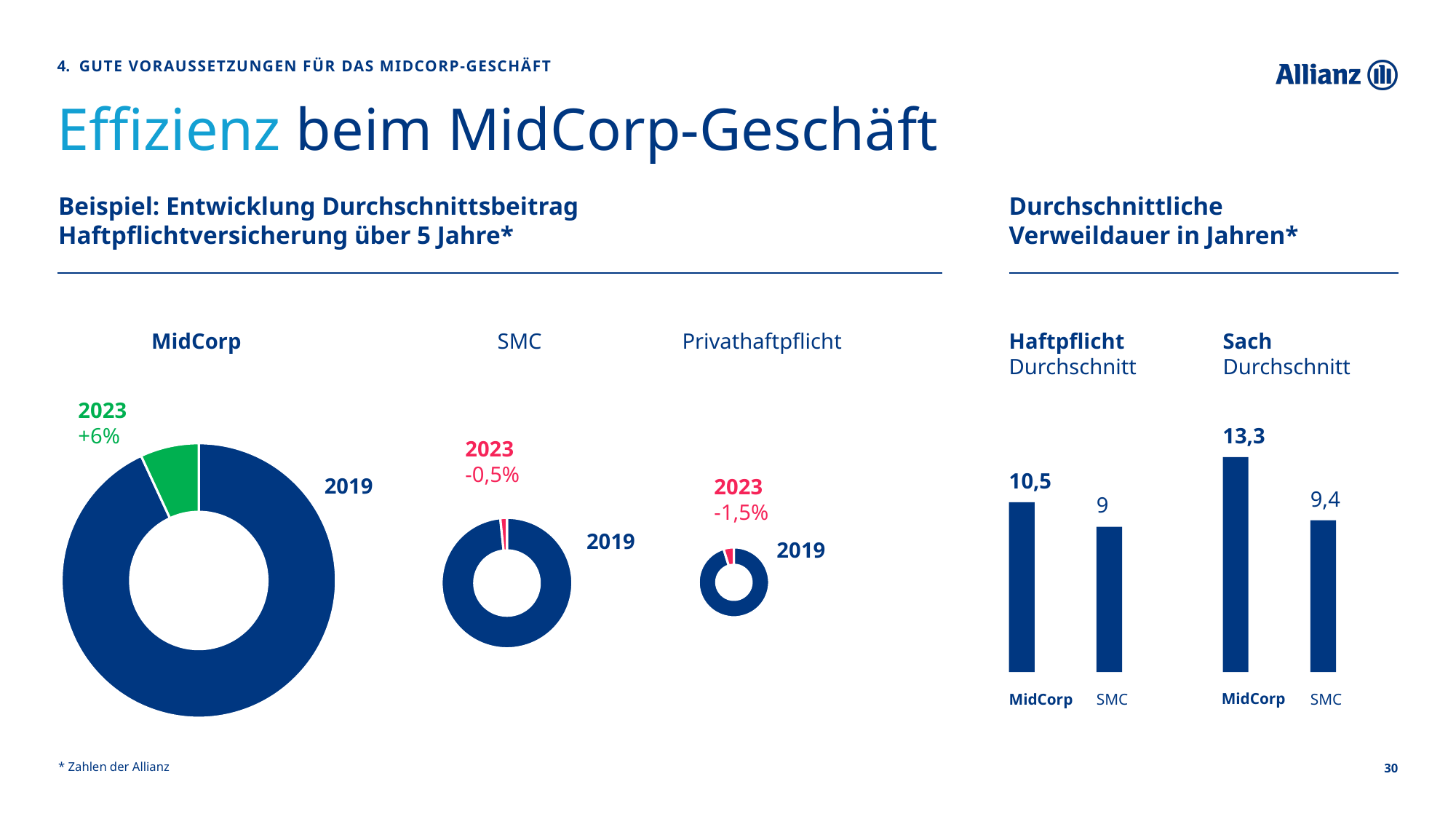
In the MidCorp donut chart on the left, what change is shown for 2023? +6% In the 'Durchschnittliche Verweildauer in Jahren' chart, what is the value for SMC under Haftpflicht Durchschnitt? 9 In the Privathaftpflicht donut chart, what change is shown for 2023? -1,5% In the 'Durchschnittliche Verweildauer in Jahren' chart, what is the value for MidCorp under Sach Durchschnitt? 13,3 In the 'Durchschnittliche Verweildauer in Jahren' chart, which bar has the lowest value? SMC (Haftpflicht Durchschnitt) In the 'Durchschnittliche Verweildauer in Jahren' chart, which bar has the highest value? MidCorp (Sach Durchschnitt) In the 'Durchschnittliche Verweildauer in Jahren' chart, what is the value for MidCorp under Haftpflicht Durchschnitt? 10,5 In the 'Durchschnittliche Verweildauer in Jahren' chart, what is the value for SMC under Sach Durchschnitt? 9,4 In the 'Durchschnittliche Verweildauer in Jahren' chart, what is the difference between MidCorp and SMC under Sach Durchschnitt? 3,9 In the 'Durchschnittliche Verweildauer in Jahren' chart, what is the difference between MidCorp and SMC under Haftpflicht Durchschnitt? 1,5 In the 'Durchschnittliche Verweildauer in Jahren' chart, which is larger: MidCorp under Haftpflicht Durchschnitt or SMC under Sach Durchschnitt? MidCorp under Haftpflicht Durchschnitt What kind of chart is used for 'Durchschnittliche Verweildauer in Jahren'? Bar chart